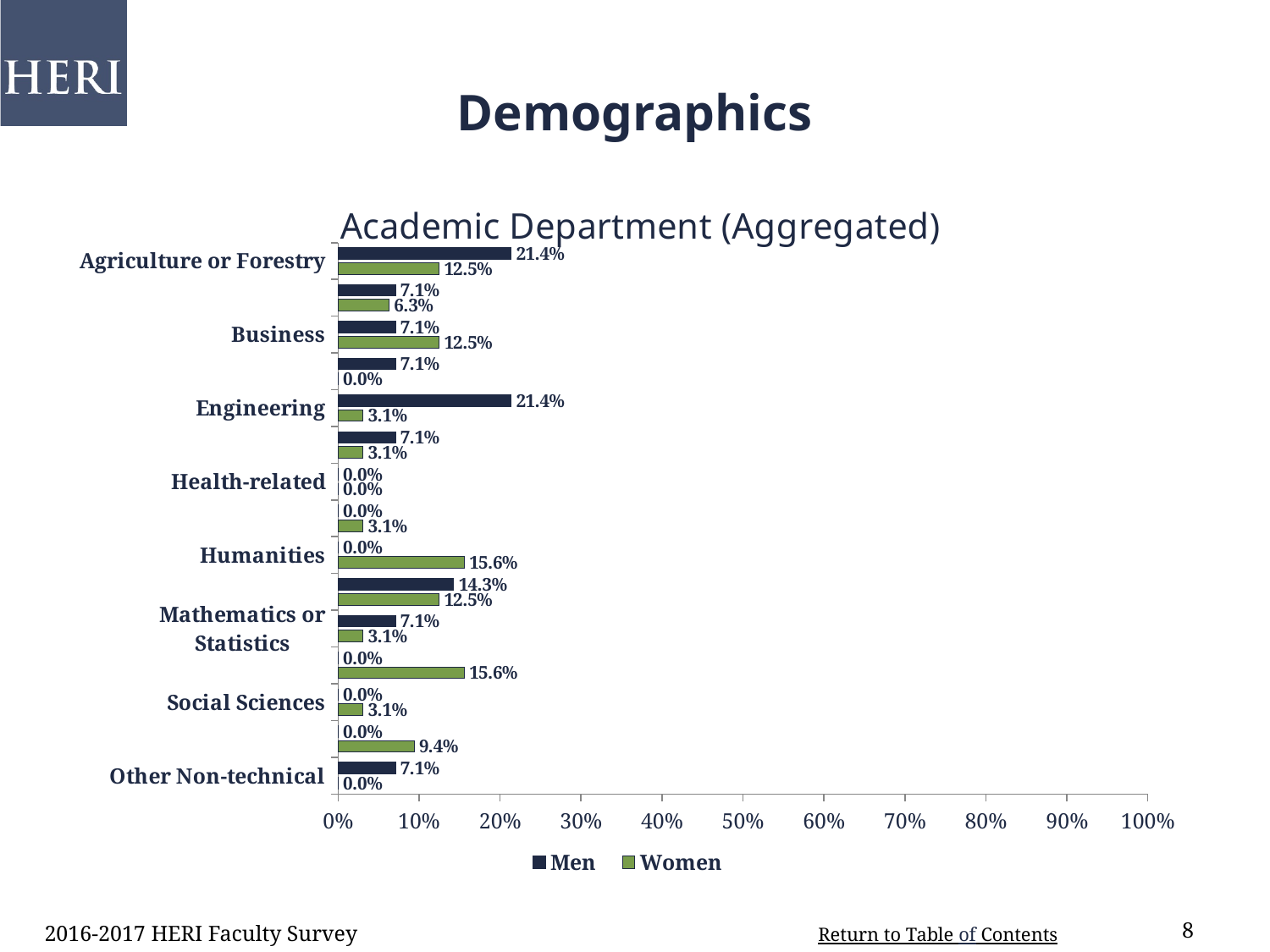
What is the value for Women in Business? 12.5% What is the value for Men in Other Non-technical? 7.1% What is the value for Women in Humanities? 15.6% What is the value for Men in Agriculture or Forestry? 21.4% How many series does the legend list? 2 What is the difference between the Men and Women values for Engineering? 18.3% Which is larger in Business, the Men value or the Women value? Women What is the value for Women in Engineering? 3.1% What is the value for Men in Mathematics or Statistics? 7.1% What is the title of the chart? Academic Department (Aggregated) What kind of chart is shown on the slide? Bar chart What is the difference between the Men and Women values for Agriculture or Forestry? 8.9%